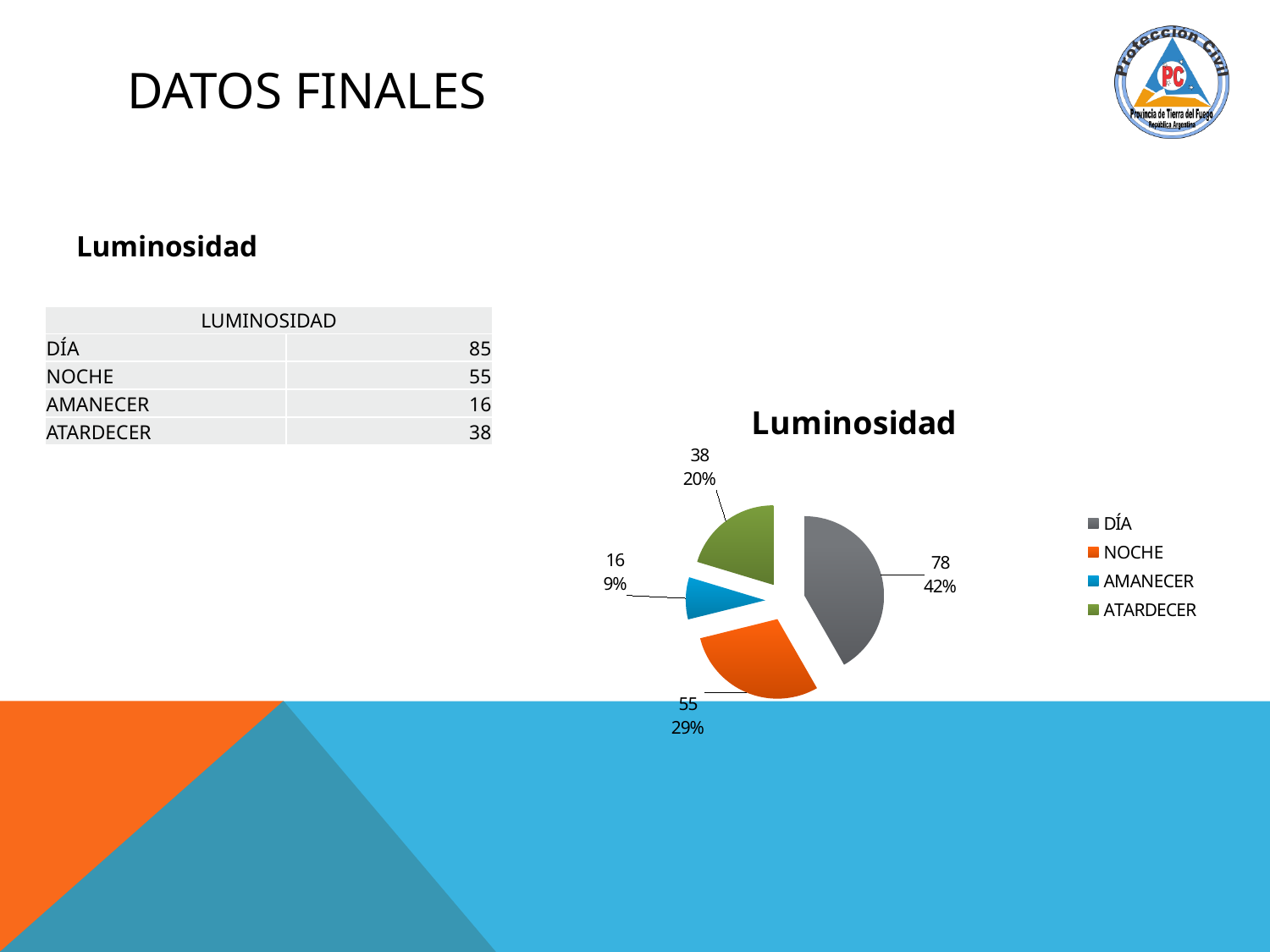
What value is shown for NOCHE in the pie chart? 55 How many slices does the pie chart have? 4 Which category has the largest slice in the pie chart? DÍA How many entries does the chart legend list? 4 What value is shown for AMANECER in the pie chart? 16 What is the title of the chart? Luminosidad What type of chart is shown on the slide? pie chart What percentage share does DÍA have in the pie chart? 42% What is the difference between the values for NOCHE and ATARDECER in the pie chart? 17 Which category has the smallest slice in the pie chart? AMANECER What value is shown for DÍA in the pie chart? 78 What percentage share does ATARDECER have in the pie chart? 20%